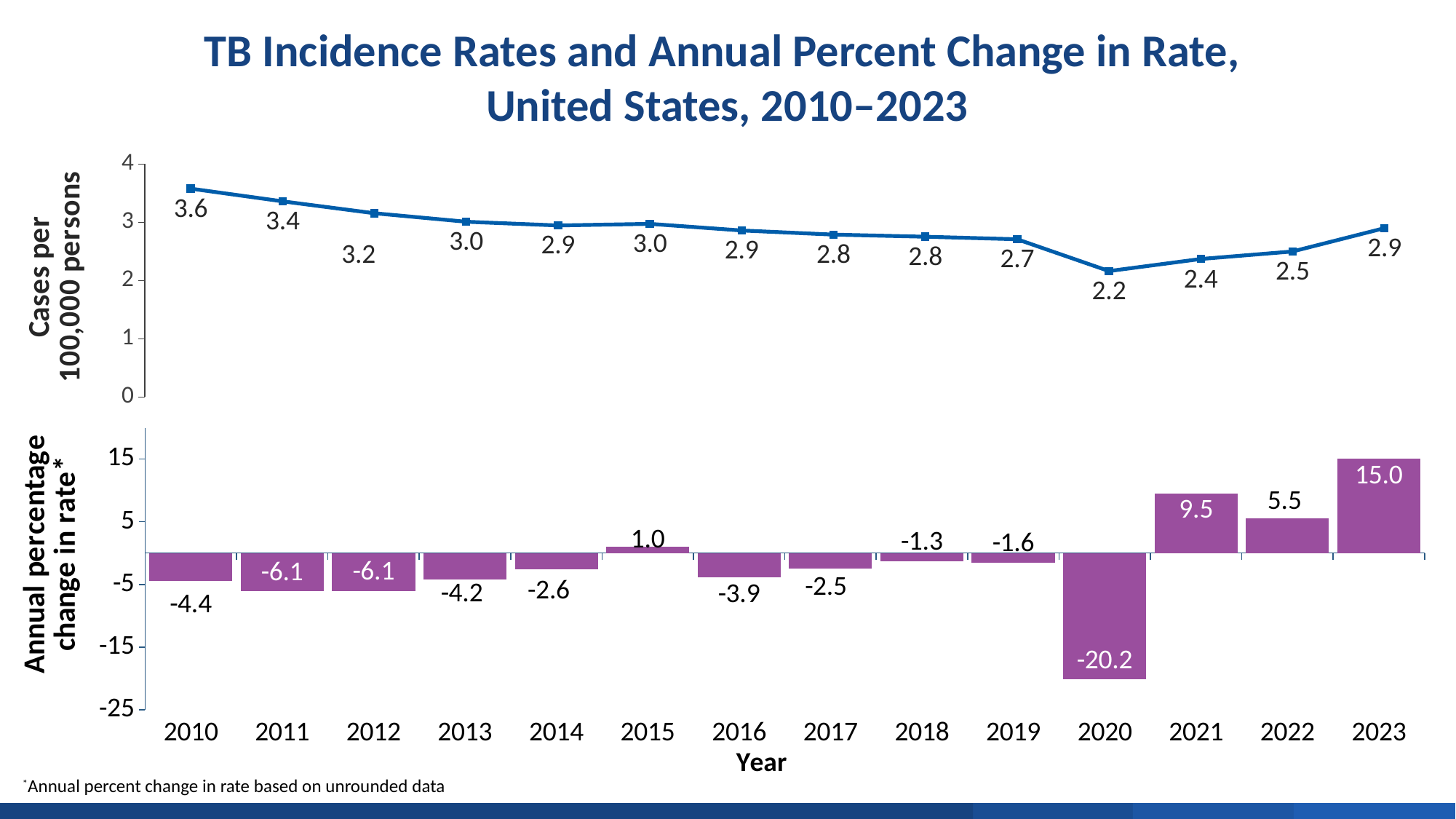
In the bottom bar chart, is the annual percentage change for 2021 larger or smaller than for 2022? larger In the top line chart, what is the TB incidence rate (cases per 100,000 persons) for 2010? 3.6 In the bottom bar chart, what is the annual percentage change in rate for 2020? -20.2 In the bottom bar chart, which year has the lowest annual percentage change in rate? 2020 In the top line chart, what is the difference between the TB incidence rate in 2010 and in 2023? 0.7 In the top line chart, what is the TB incidence rate for 2020? 2.2 How many years are shown on the x axis of the charts? 14 What kind of chart is the bottom chart showing annual percentage change in rate? bar chart In the top line chart, which year has the lowest TB incidence rate? 2020 In the bottom bar chart, which year has the largest annual percentage change in rate? 2023 In the bottom bar chart, what is the annual percentage change in rate for 2023? 15.0 In the top line chart, which year has the highest TB incidence rate? 2010